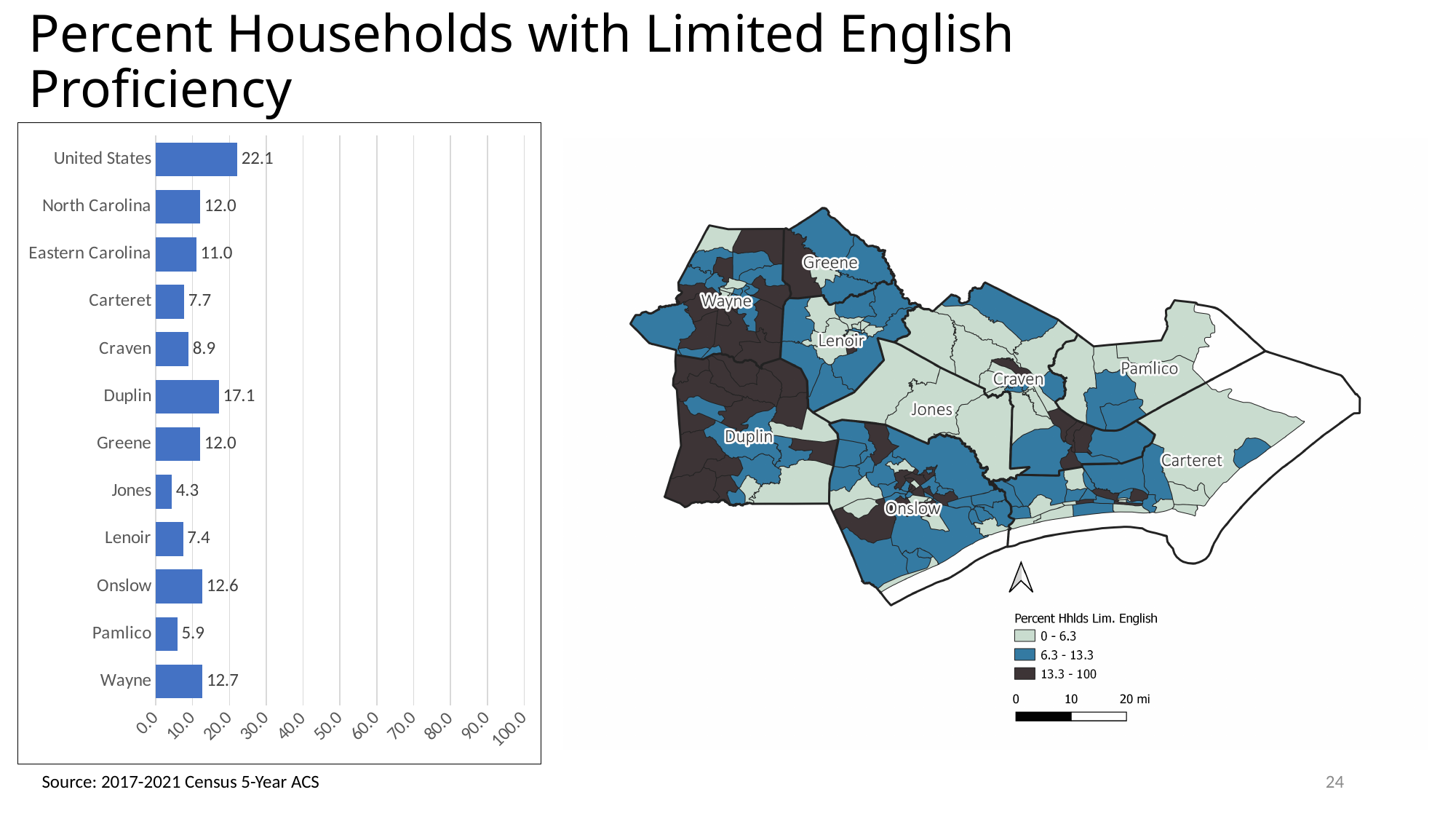
Which has a larger value in the bar chart, Onslow or Craven? Onslow What is the value for the United States in the bar chart? 22.1 How many categories are shown in the bar chart? 12 What is the value for Duplin in the bar chart? 17.1 Is the value for Carteret in the bar chart greater or less than 10.0? less What is the difference between the values for Duplin and Pamlico in the bar chart? 11.2 Which category has the highest value in the bar chart? United States What is the value for Eastern Carolina in the bar chart? 11.0 What is the highest value shown on the x axis of the bar chart? 100.0 What is the value for Jones in the bar chart? 4.3 Which category has the lowest value in the bar chart? Jones What kind of chart is shown on the left of the slide? Bar chart